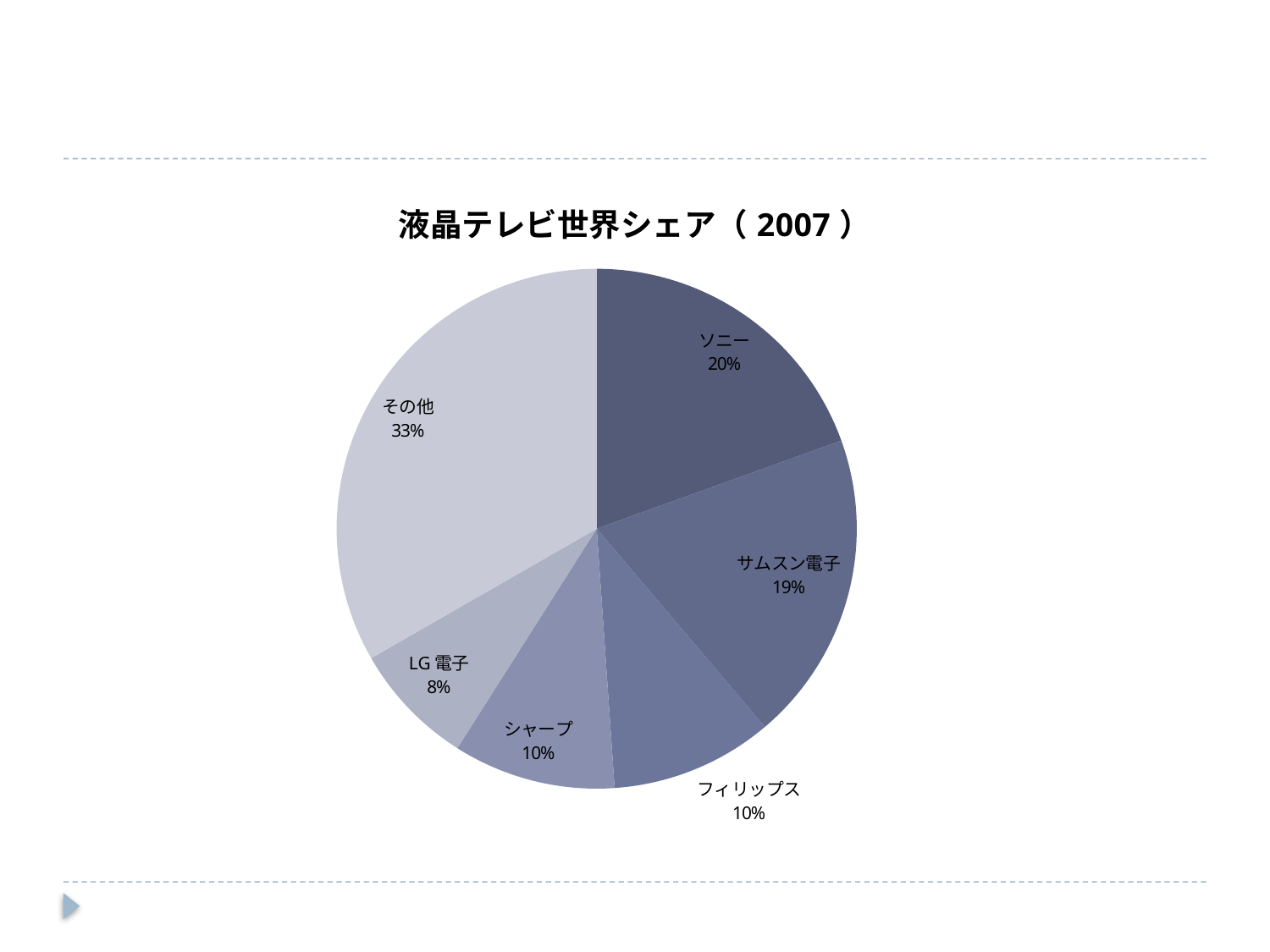
What share does サムスン電子 have? 19% What kind of chart is shown on the slide? pie chart Which slice is the largest in the pie chart? その他 What is the combined share of シャープ and フィリップス? 20% What share does ソニー have in the pie chart? 20% How many slices does the pie chart have? 6 What is the title of the chart? 液晶テレビ世界シェア（2007） What share does シャープ have? 10% What share does LG 電子 have? 8% What is the difference in share between その他 and ソニー? 13% Which has a larger share, ソニー or LG 電子? ソニー Which slice is the smallest in the pie chart? LG 電子